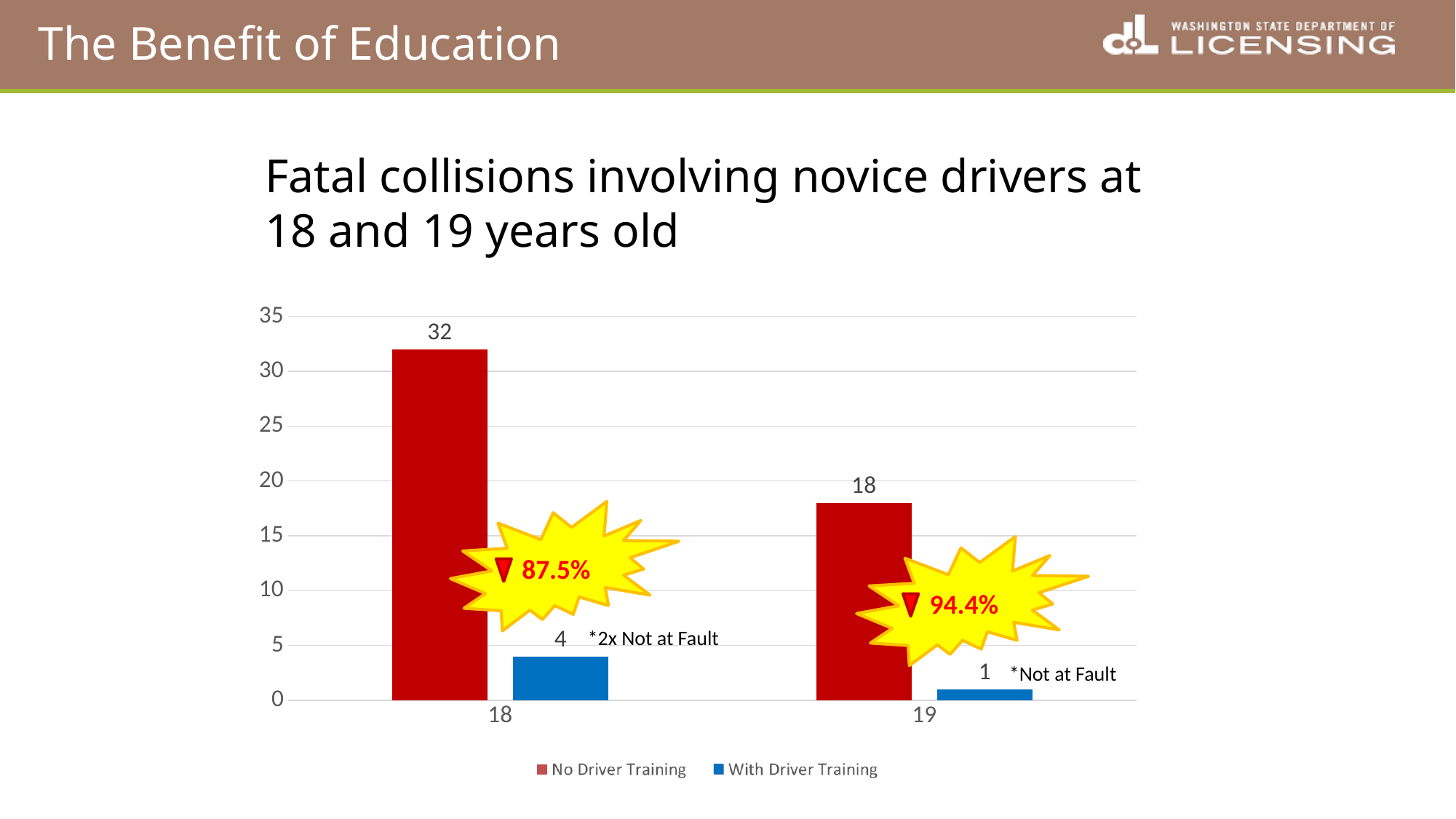
What is the difference between the No Driver Training values for ages 18 and 19? 14 What is the value for No Driver Training at age 18? 32 What is the value for With Driver Training at age 18? 4 Which age group has the highest No Driver Training value? 18 Which bar has the lowest value on the chart? With Driver Training at age 19 How many series does the legend list? 2 Which is larger at age 19: No Driver Training or With Driver Training? No Driver Training What is the value for With Driver Training at age 19? 1 What is the value for No Driver Training at age 19? 18 What kind of chart is shown? Bar chart What is the difference between No Driver Training and With Driver Training at age 18? 28 What percentage decrease is shown in the callout for age 19? 94.4%